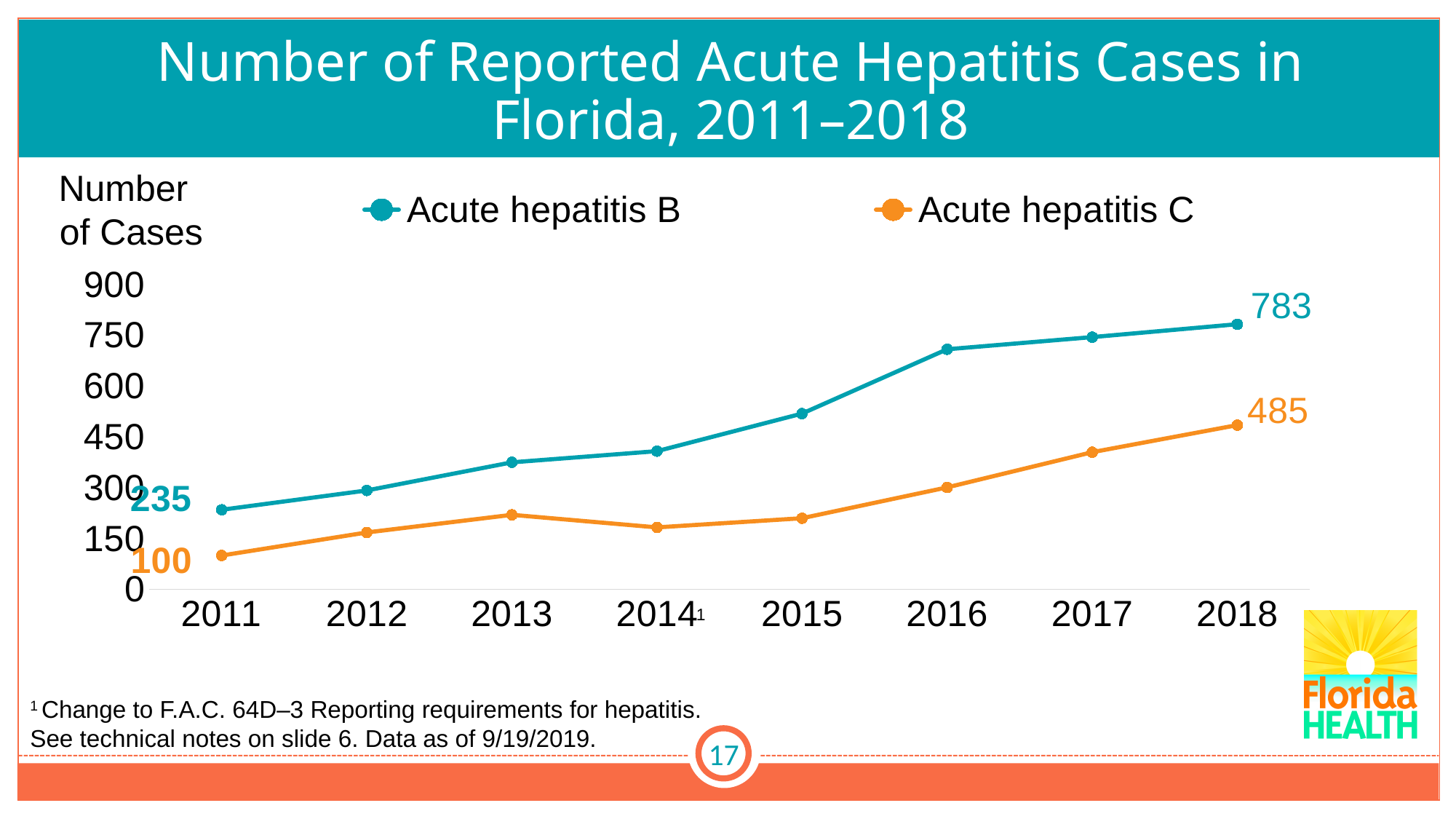
In 2018, which series has more cases, acute hepatitis B or acute hepatitis C? Acute hepatitis B What is the number of reported acute hepatitis C cases in 2011? 100 By how much did acute hepatitis B cases increase from 2011 to 2018? 548 What is the number of reported acute hepatitis B cases in 2011? 235 What kind of chart is shown on the slide? Line chart Is the value for acute hepatitis B in 2016 greater or less than 600? greater What is the difference between acute hepatitis B and acute hepatitis C cases in 2018? 298 How many series does the legend list? 2 What is the number of reported acute hepatitis B cases in 2018? 783 How many years are shown on the x axis? 8 Is the value for acute hepatitis C in 2014 greater or less than 300? less What is the number of reported acute hepatitis C cases in 2018? 485